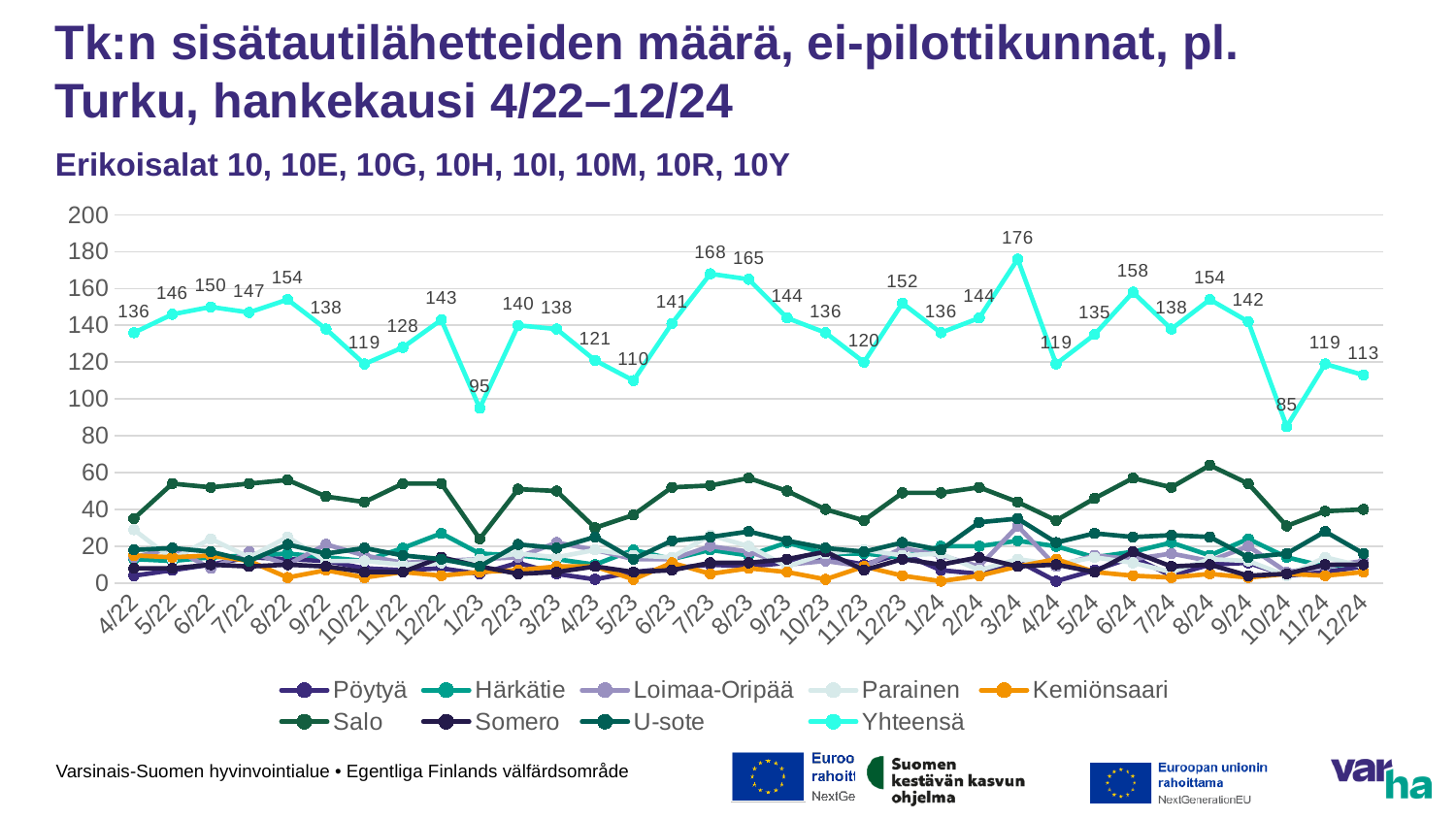
What is the Yhteensä value for 3/24? 176 What is the Yhteensä value for 4/22? 136 What is the Yhteensä value for 1/23? 95 In which month does the Yhteensä series reach its highest value? 3/24 How many series does the legend list? 9 Is the value for Salo in 1/23 greater or less than 40? less What is the difference between the highest Yhteensä value (3/24) and the lowest (10/24)? 91 In which month does the Yhteensä series reach its lowest value? 10/24 What kind of chart is shown on the slide? line chart How many months are plotted on the x axis? 33 Which month has the larger Yhteensä value, 7/23 or 8/23? 7/23 What is the difference between the Yhteensä values for 11/24 and 12/24? 6